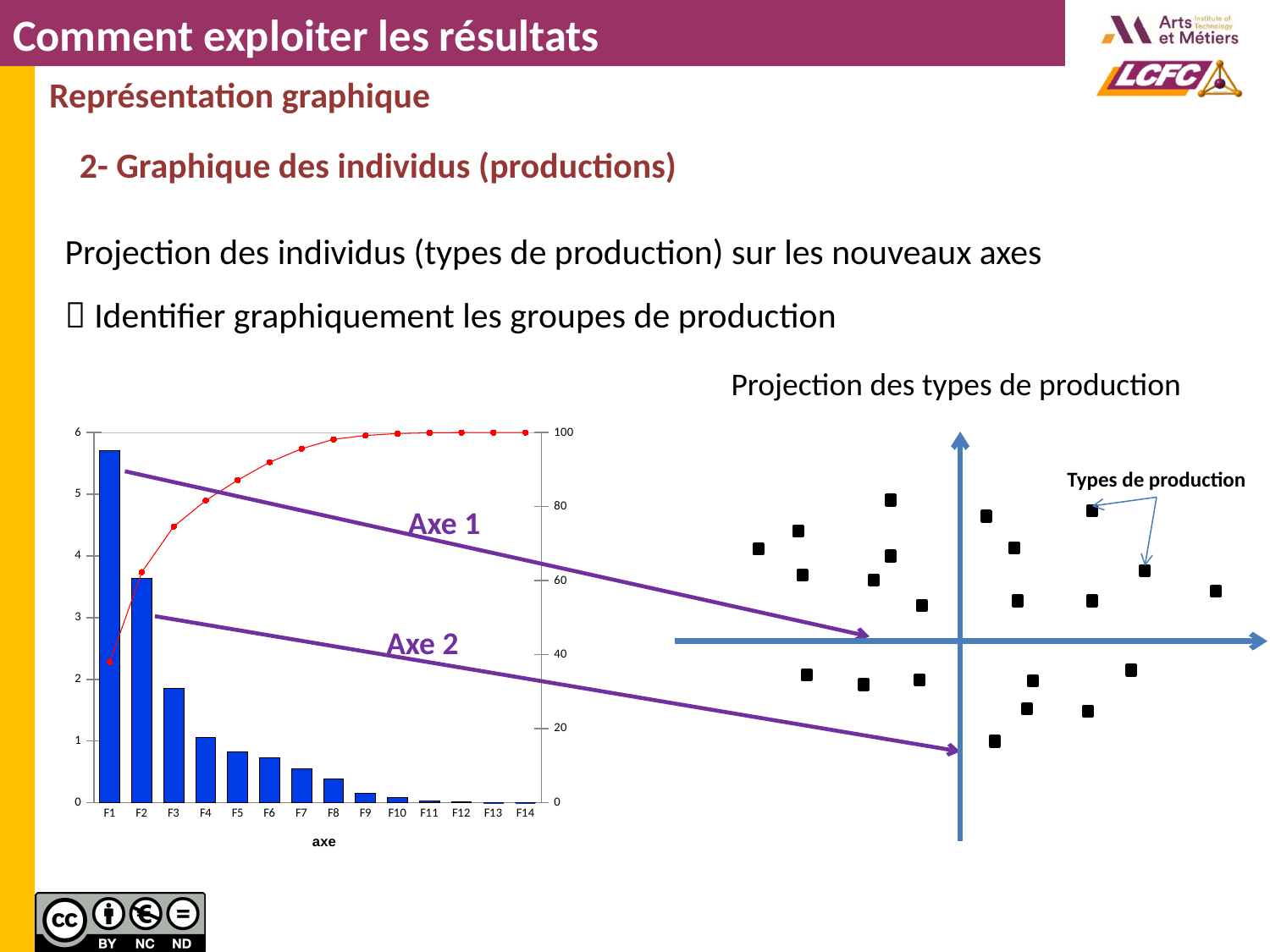
What is the title of the x axis of the bar chart on the left? axe In the bar chart on the left, is the value for F1 greater or less than 5? greater In the bar chart on the left, which category has the highest bar? F1 In the bar chart on the left, which is larger, the value for F3 or the value for F4? F3 In the bar chart on the left, does the red line rise or fall from F1 to F14? rise What kind of chart is the chart on the left of the slide (with categories F1 to F14)? combination bar and line chart How many categories are shown on the x axis of the bar chart on the left? 14 In the bar chart on the left, is the value for F3 greater or less than 2? less In the bar chart on the left, is the value for F2 greater or less than 3? greater In the bar chart on the left, which is larger, the value for F1 or the value for F2? F1 In the bar chart on the left, do the bar values rise or fall from F1 to F14? fall